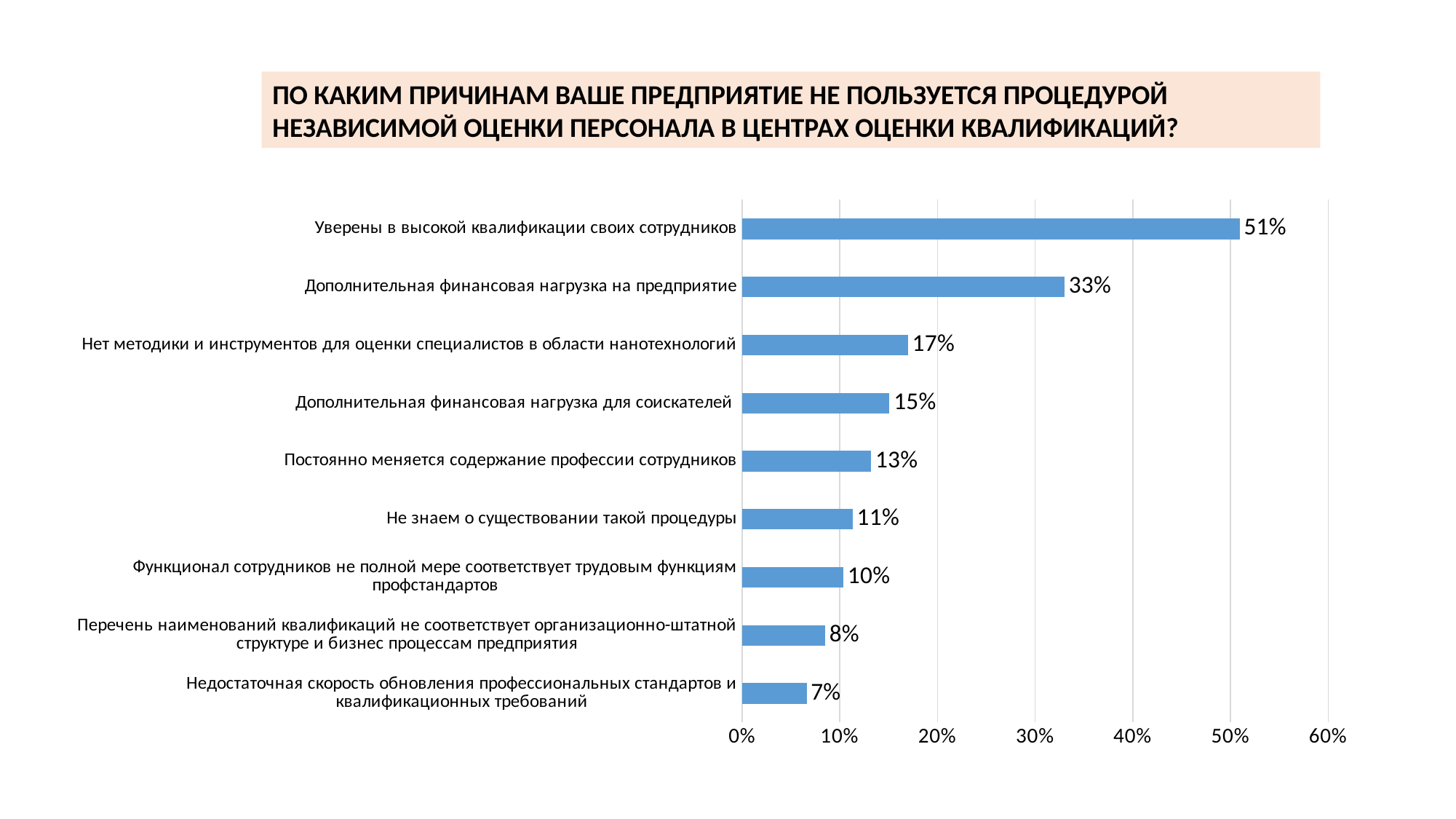
Which category has the lowest value? Недостаточная скорость обновления профессиональных стандартов и квалификационных требований Which is larger: the value for "Нет методики и инструментов для оценки специалистов в области нанотехнологий" or for "Дополнительная финансовая нагрузка для соискателей"? Нет методики и инструментов для оценки специалистов в области нанотехнологий Which category has the highest value? Уверены в высокой квалификации своих сотрудников What kind of chart is shown on the slide? bar chart How many categories are shown in the chart? 9 What is the maximum value shown on the horizontal axis? 60% Is the value for "Постоянно меняется содержание профессии сотрудников" greater or less than 10%? greater What is the value for "Дополнительная финансовая нагрузка на предприятие"? 33% What is the value for "Не знаем о существовании такой процедуры"? 11% What is the value for "Недостаточная скорость обновления профессиональных стандартов и квалификационных требований"? 7% What is the value for "Уверены в высокой квалификации своих сотрудников"? 51% What is the difference between the values for "Уверены в высокой квалификации своих сотрудников" and "Дополнительная финансовая нагрузка на предприятие"? 18%